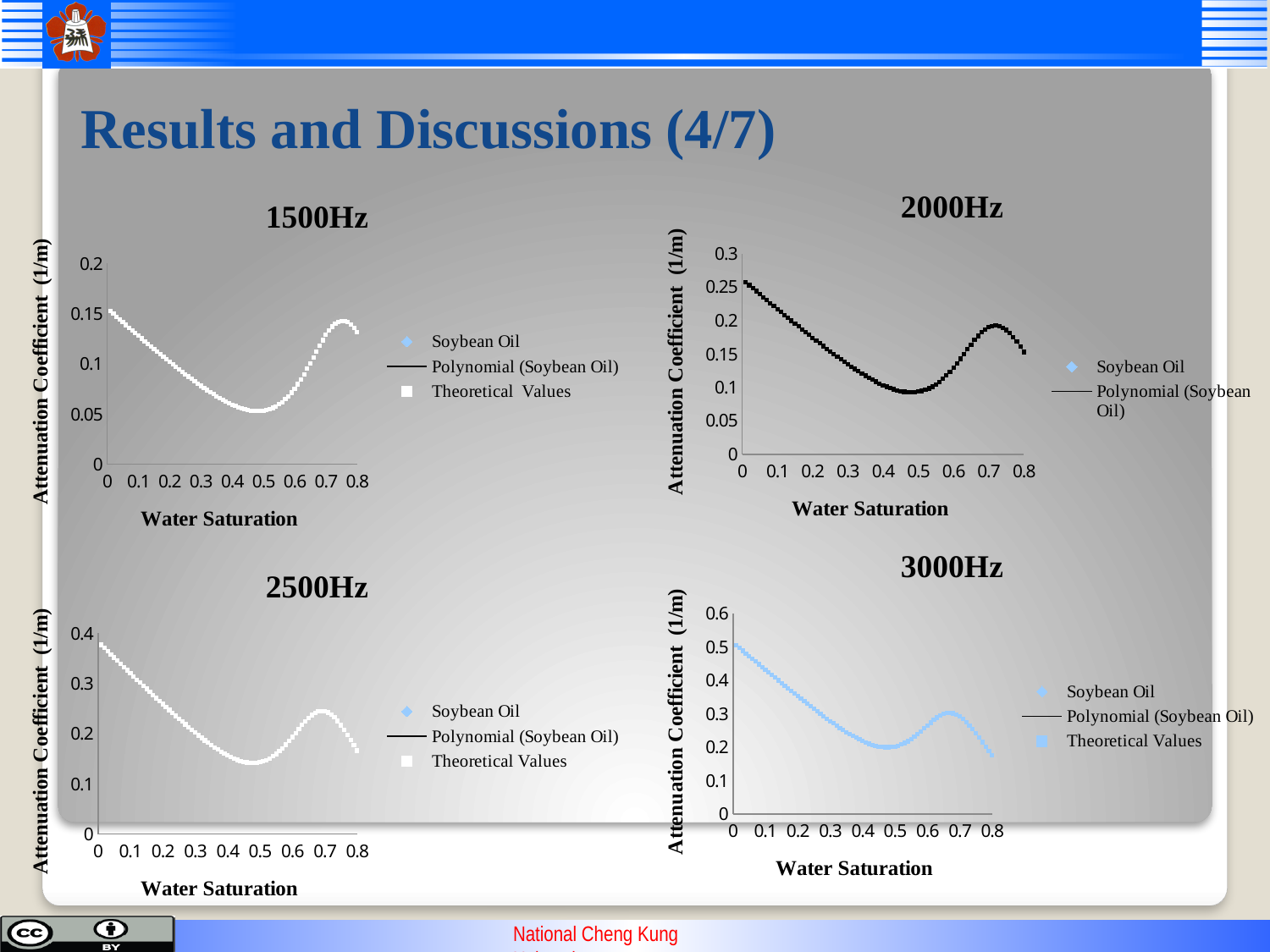
What is the label of the x axis in the 3000Hz chart? Water Saturation How many series does the legend of the 1500Hz chart list? 3 How many series does the legend of the 2000Hz chart list? 2 In the 1500Hz chart, is the attenuation coefficient at water saturation 0.5 greater or less than 0.1? less In the 2500Hz chart, is the attenuation coefficient at water saturation 0 greater or less than 0.3? greater In the 3000Hz chart, is the attenuation coefficient at water saturation 0 greater or less than 0.4? greater In the 2500Hz chart, do the attenuation coefficient values rise or fall as water saturation increases from 0 to 0.4? fall In the 2000Hz chart, do the attenuation coefficient values rise or fall as water saturation increases from 0.5 to 0.7? rise